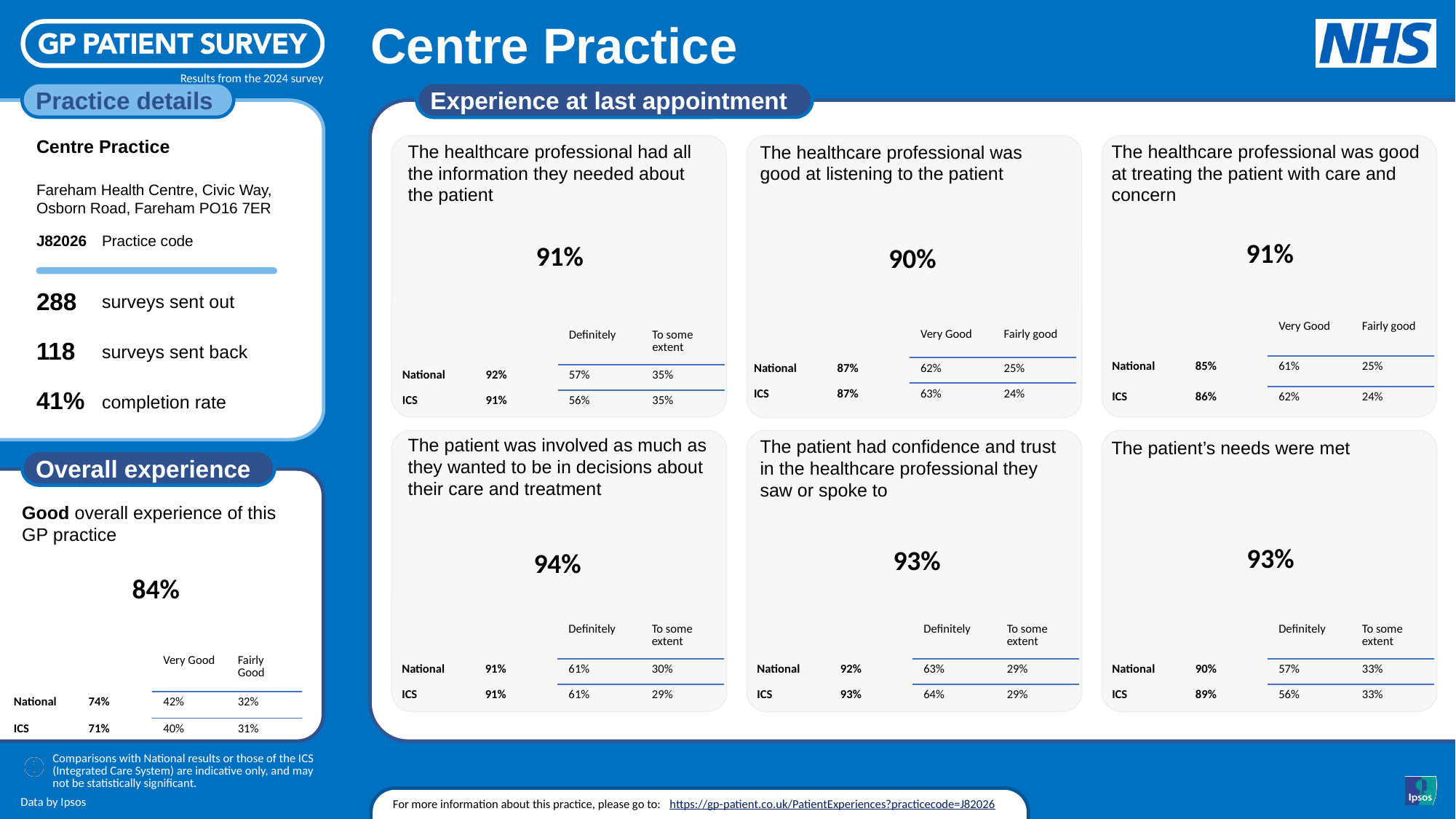
On the panel 'The healthcare professional was good at listening to the patient', what is the practice's percentage? 90% Among the six 'Experience at last appointment' panels, which question has the highest practice percentage? The patient was involved as much as they wanted to be in decisions about their care and treatment On the 'Overall experience' panel, what is the ICS value for good overall experience? 71% On the 'Overall experience' panel, what is the difference between the practice's 84% and the National 74%? 10 percentage points Among the six 'Experience at last appointment' panels, which question has the lowest practice percentage? The healthcare professional was good at listening to the patient How many question panels are shown under 'Experience at last appointment'? 6 On the panel 'The patient was involved as much as they wanted to be in decisions about their care and treatment', what is the practice's percentage? 94% On the panel 'The healthcare professional was good at treating the patient with care and concern', which is larger: the practice's value or the ICS value? The practice's value On the panel 'The healthcare professional had all the information they needed about the patient', what is the practice's percentage? 91% On the 'Overall experience' panel, what is the National value for good overall experience? 74% On the 'Overall experience' panel, what percentage of patients reported a good overall experience of this GP practice? 84% On the panel 'The patient's needs were met', what is the National value? 90%